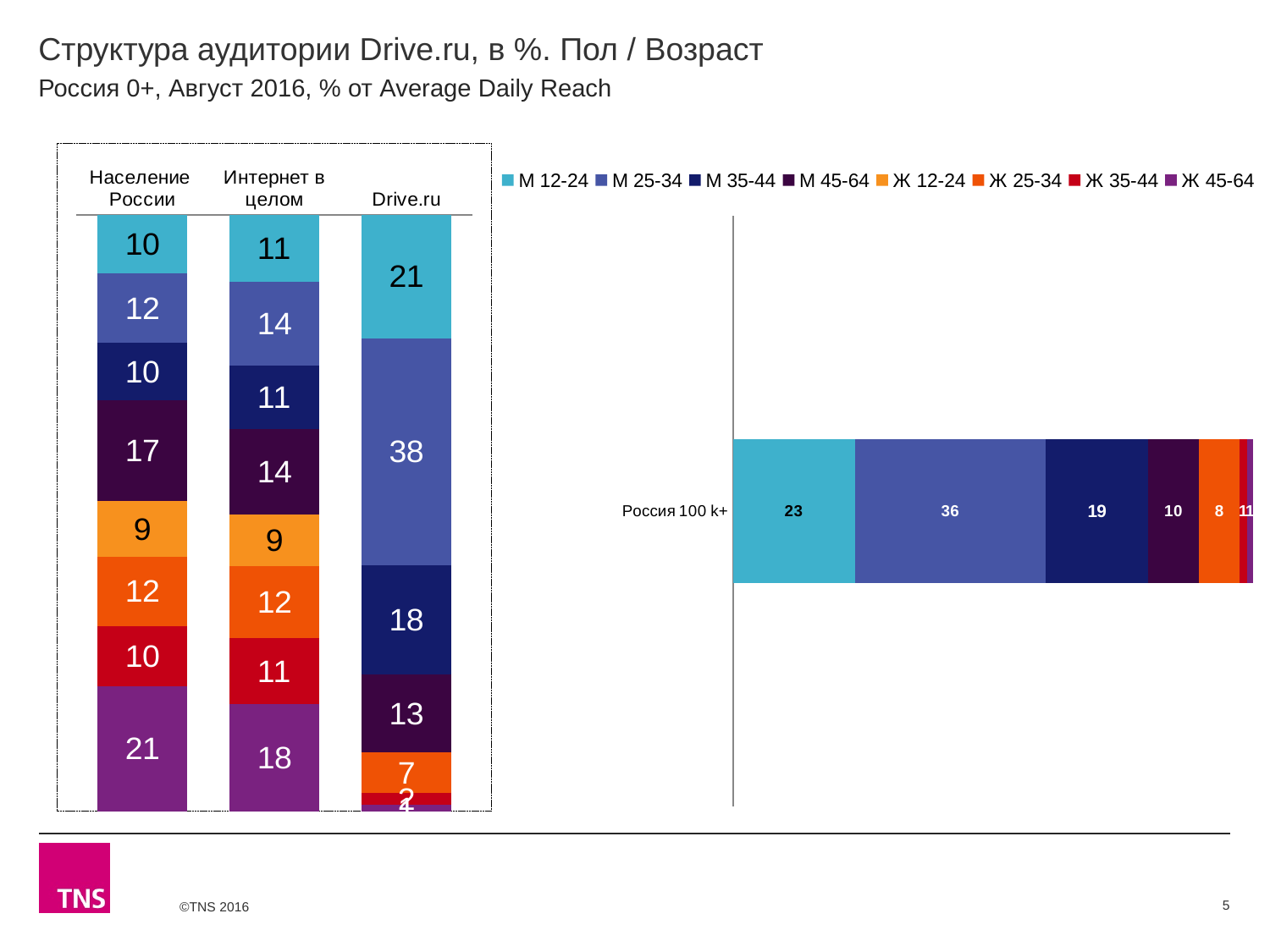
In the right chart, which series has the largest segment for Россия 100 k+? М 25-34 How many bars are shown in the left chart? 3 What kind of chart is the right chart? Stacked bar chart In the left chart, what is the difference between the М 12-24 value for Drive.ru and the М 12-24 value for Население России? 11 In the right chart, what is the value of the М 35-44 segment for Россия 100 k+? 19 In the left chart, what is the value of the М 25-34 segment for Drive.ru? 38 In the left chart, what is the value of the М 25-34 segment for Интернет в целом? 14 In the left chart, which series has the largest segment in the Drive.ru bar? М 25-34 In the right chart, what is the value of the М 12-24 segment for Россия 100 k+? 23 How many series does the legend list? 8 In the left chart, what is the value of the Ж 45-64 segment for Население России? 21 In the left chart, which is larger: the Ж 45-64 value for Население России or for Интернет в целом? Население России